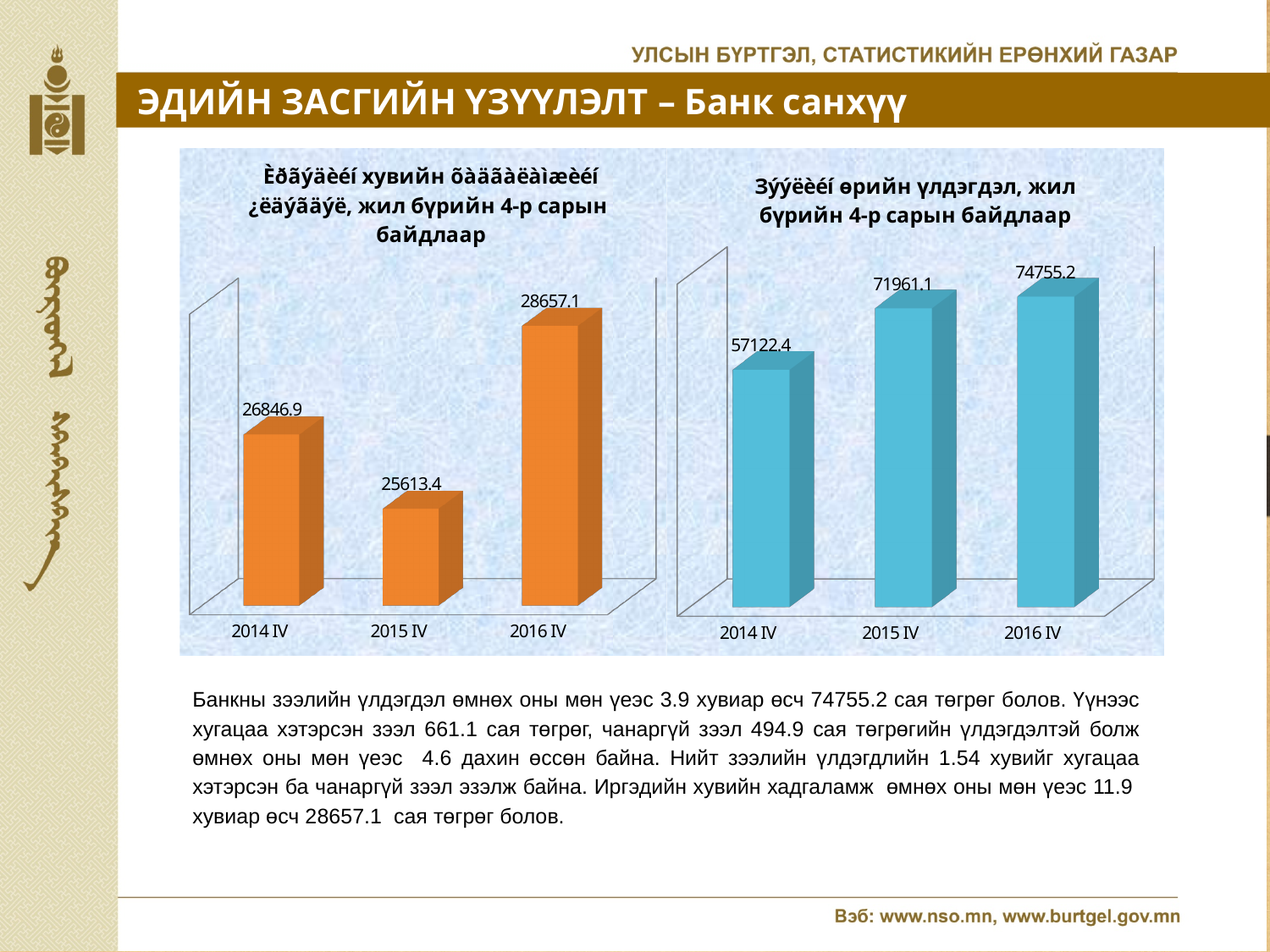
In the right chart, what is the value for 2014 IV? 57122.4 In the right chart, what is the difference between the values for 2015 IV and 2014 IV? 14838.7 What type of chart is the left chart? bar chart In the right chart, which category has the lowest value? 2014 IV In the left chart, what is the value for 2015 IV? 25613.4 In the left chart, which category has the lowest value? 2015 IV In the left chart, what is the difference between the values for 2016 IV and 2015 IV? 3043.7 How many categories are shown in the right chart? 3 In the left chart, what is the value for 2014 IV? 26846.9 In the right chart, do the values rise or fall from 2014 IV to 2016 IV? rise In the right chart, what is the value for 2016 IV? 74755.2 In the left chart, which category has the highest value? 2016 IV